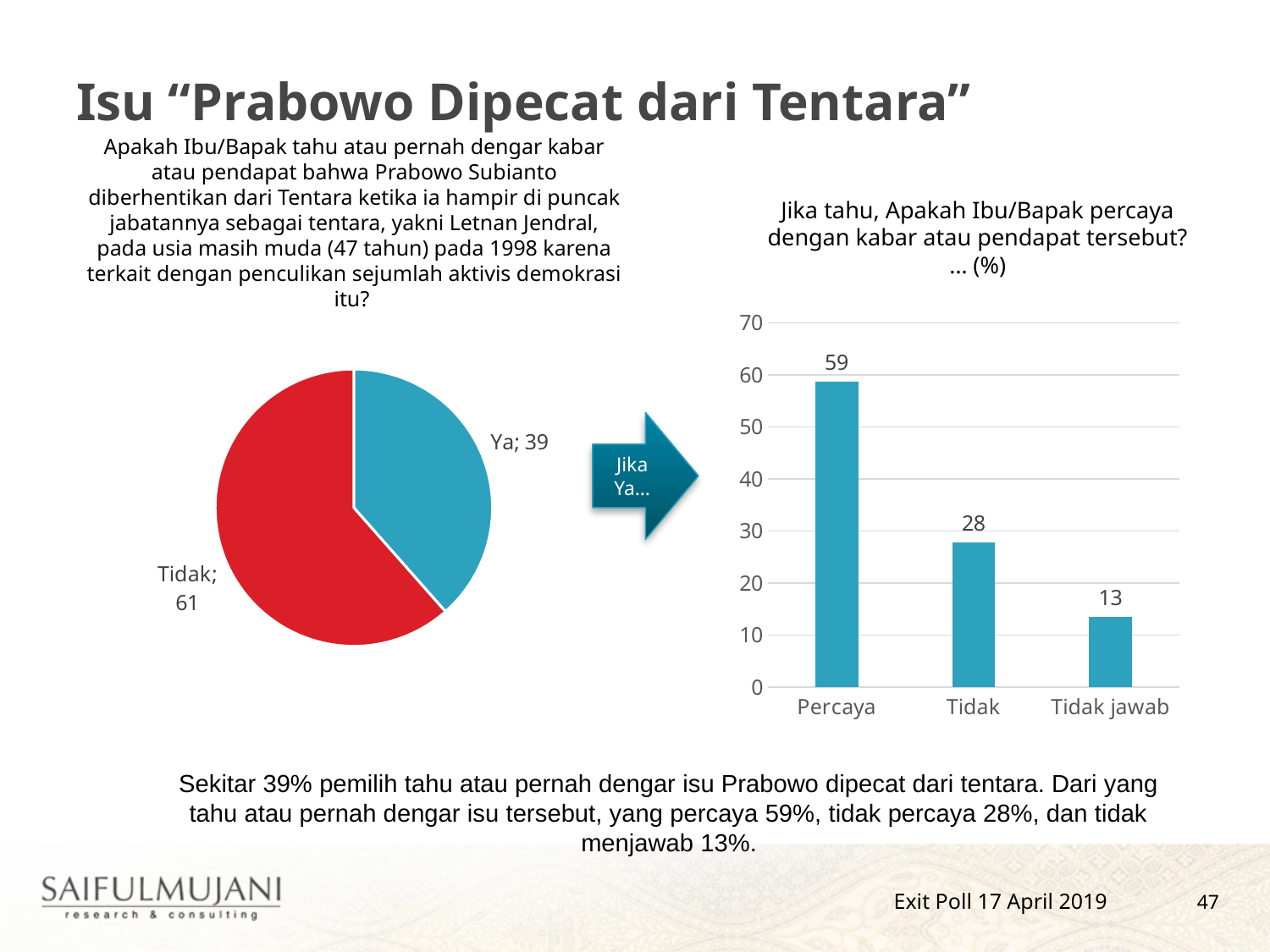
In the bar chart on the right, what is the value for "Percaya"? 59 In the pie chart on the left, what is the value for "Tidak"? 61 In the pie chart on the left, what is the difference between the "Tidak" and "Ya" values? 22 In the pie chart on the left, which slice is larger, "Ya" or "Tidak"? Tidak How many categories are shown in the bar chart on the right? 3 How many slices does the pie chart on the left have? 2 What type of chart is the chart on the right of the slide? Bar chart In the bar chart on the right, what is the difference between "Percaya" and "Tidak"? 31 In the pie chart on the left, what is the value for "Ya"? 39 In the bar chart on the right, what is the value for "Tidak jawab"? 13 In the bar chart on the right, which category has the lowest value? Tidak jawab What type of chart is the chart on the left of the slide? Pie chart